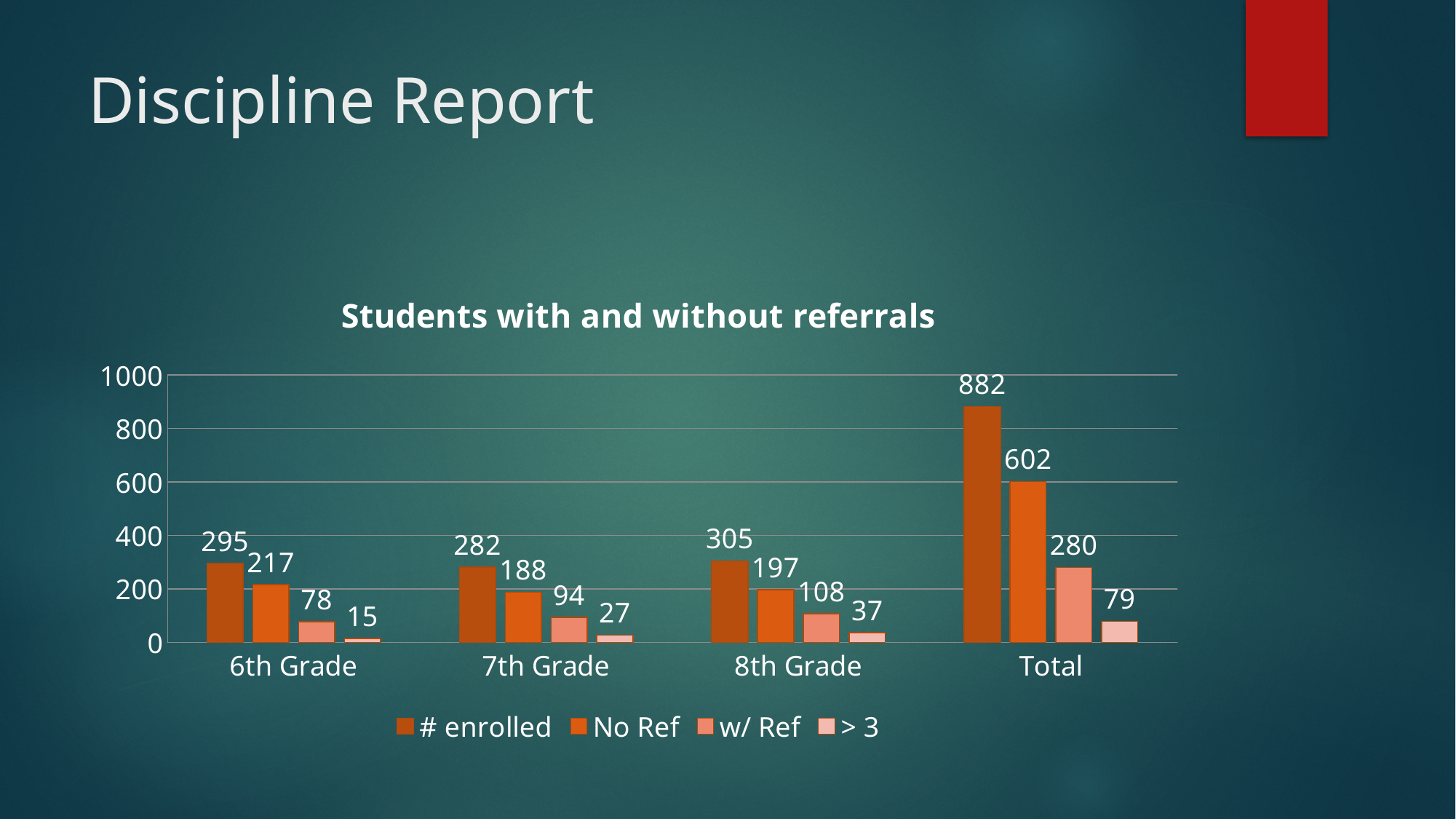
Which grade has the highest '# enrolled' value among 6th, 7th and 8th Grade? 8th Grade What is the difference between '# enrolled' and 'No Ref' in 6th Grade? 78 Is the 'No Ref' value for Total greater or less than 800? less What is the value for 'No Ref' in 7th Grade? 188 Which category has the lowest 'w/ Ref' value? 6th Grade Which is larger: 'w/ Ref' in 7th Grade or 'w/ Ref' in 8th Grade? 8th Grade What is the value for '> 3' in 6th Grade? 15 What is the value for '# enrolled' in 8th Grade? 305 How many categories are shown on the x axis? 4 What is the value for 'w/ Ref' in the Total category? 280 How many series does the legend list? 4 What type of chart is shown on the slide? Bar chart